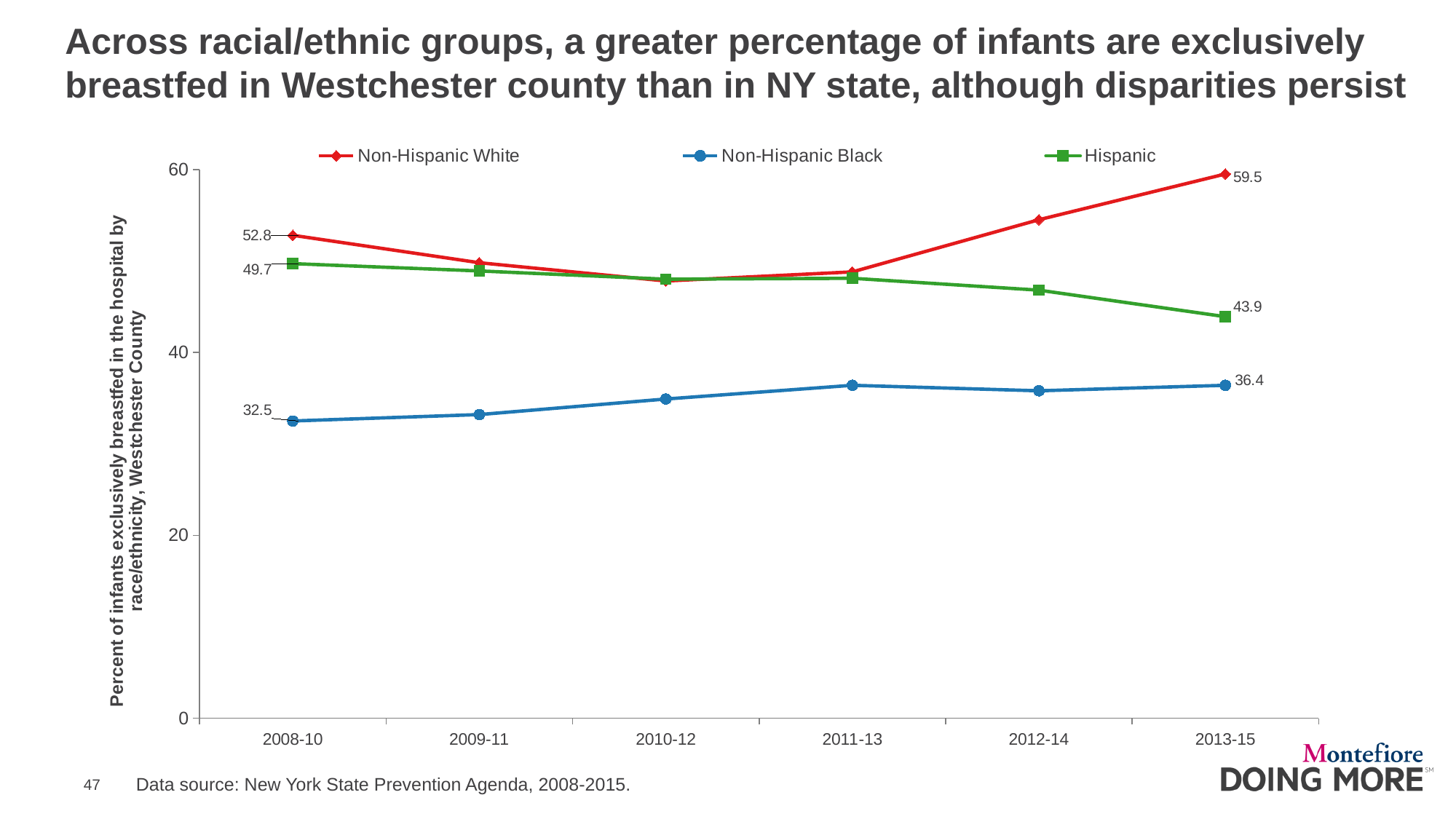
Which series has the lowest value in 2008-10? Non-Hispanic Black What kind of chart is shown on the slide? line chart Which series has the highest value in 2013-15? Non-Hispanic White How many series does the legend list? 3 What is the difference between the Non-Hispanic White value in 2013-15 and in 2008-10? 6.7 Which is larger in 2013-15: the Hispanic value or the Non-Hispanic Black value? Hispanic What is the value for Hispanic in 2008-10? 49.7 What is the value for Non-Hispanic White in 2013-15? 59.5 What is the value for Hispanic in 2013-15? 43.9 Is the value for Non-Hispanic Black in 2011-13 greater or less than 40? less What is the value for Non-Hispanic Black in 2008-10? 32.5 How many time periods are shown on the x axis? 6